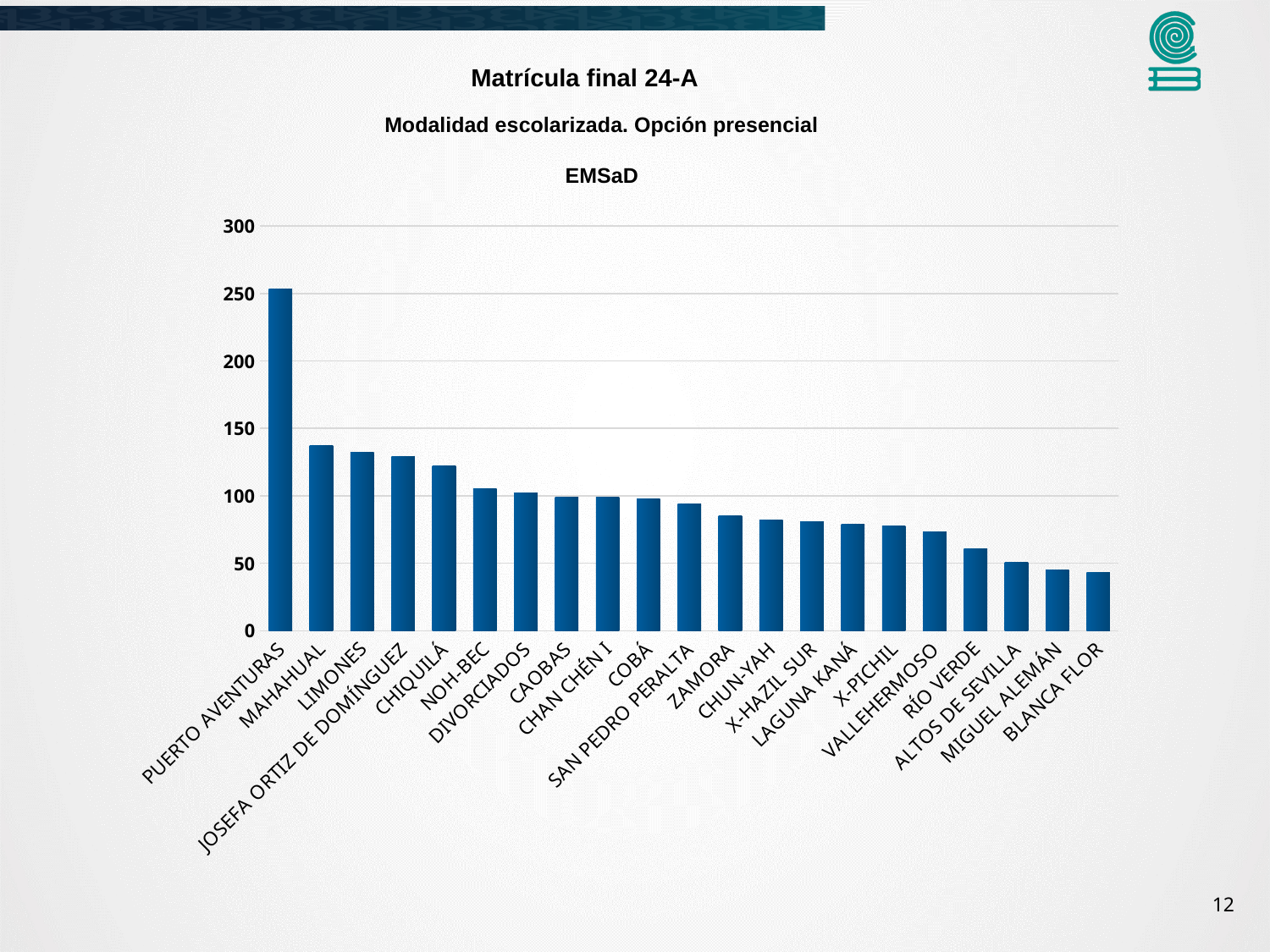
What is the title shown directly above the chart? EMSaD Is the value for RÍO VERDE greater or less than 50? greater Do the values rise or fall moving from left to right along the x axis? fall Is the value for MAHAHUAL greater or less than 150? less Is the value for VALLEHERMOSO greater or less than 100? less Which category has the highest value on the chart? PUERTO AVENTURAS Which has a larger value, PUERTO AVENTURAS or MAHAHUAL? PUERTO AVENTURAS What kind of chart is shown on the slide? Bar chart How many categories (schools) are plotted on the chart? 21